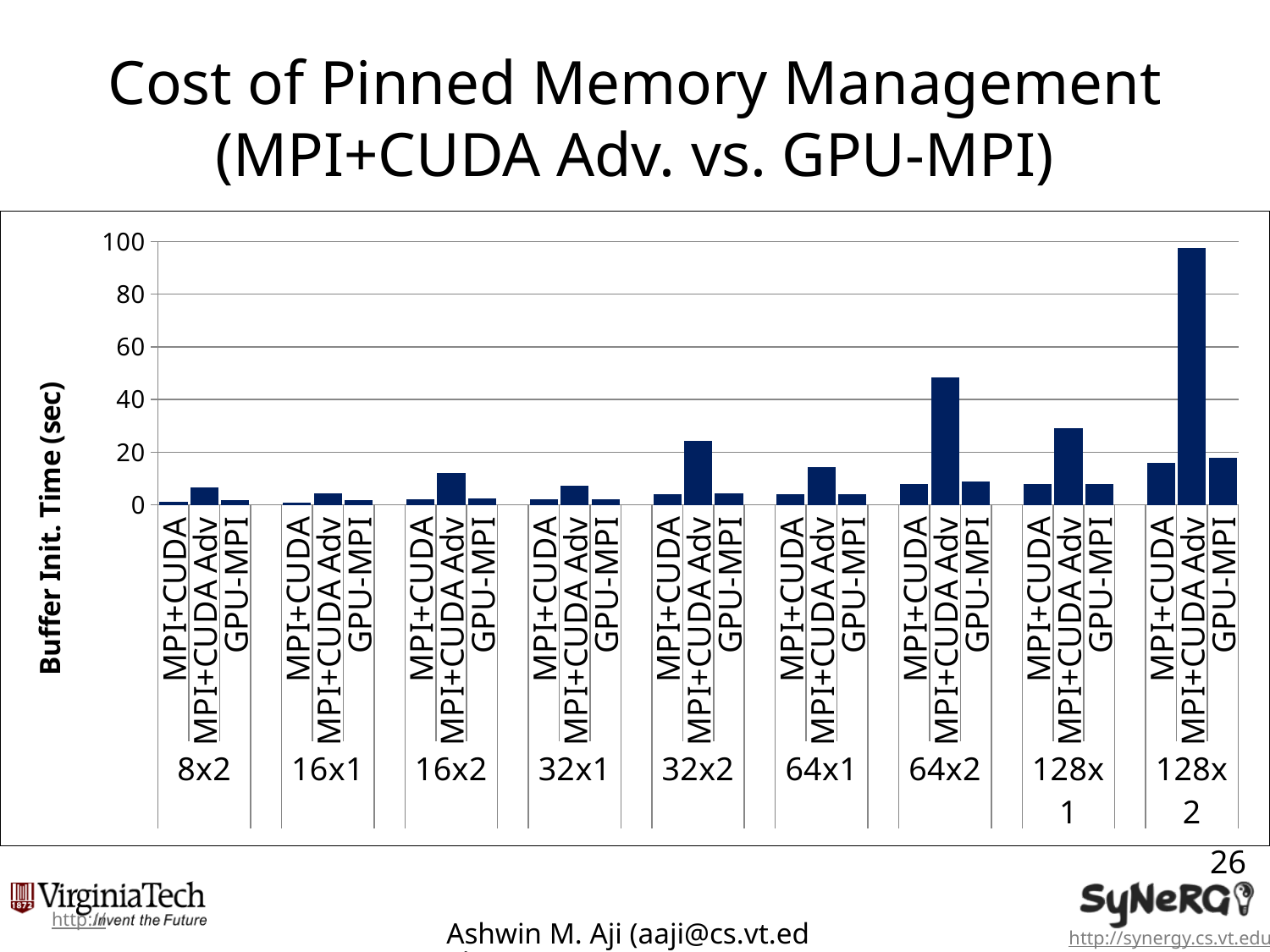
Is the value for MPI+CUDA Adv at 128x2 greater or less than 80? greater Is the value for MPI+CUDA Adv at 64x2 greater or less than 40? greater Within the 32x2 group, which is larger: MPI+CUDA or MPI+CUDA Adv? MPI+CUDA Adv How many bars are plotted within each configuration group? 3 What is the label of the y axis? Buffer Init. Time (sec) Which bar has the highest Buffer Init. Time in the chart? MPI+CUDA Adv at 128x2 How many configuration groups (such as 8x2, 16x1) are shown along the x axis? 9 What is the maximum value shown on the y axis? 100 What kind of chart is shown on the slide? bar chart Is the value for MPI+CUDA Adv at 128x1 greater or less than 40? less Within the 64x2 group, which is larger: MPI+CUDA Adv or GPU-MPI? MPI+CUDA Adv